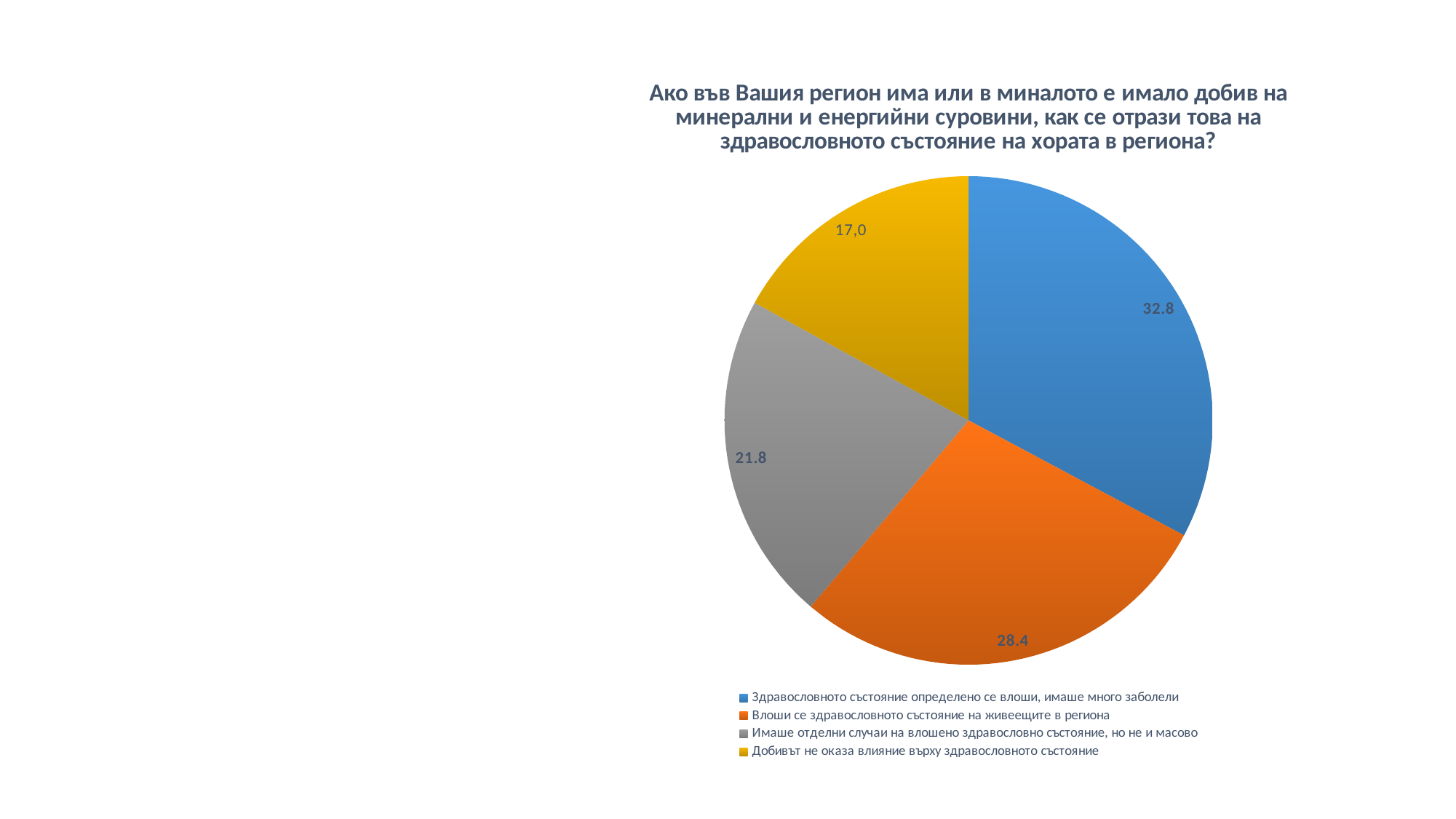
Which is larger: the value for "Имаше отделни случаи на влошено здравословно състояние, но не и масово" or the value for "Добивът не оказа влияние върху здравословното състояние"? Имаше отделни случаи на влошено здравословно състояние, но не и масово Which category has the smallest slice of the pie? Добивът не оказа влияние върху здравословното състояние What is the difference between the values for "Здравословното състояние определено се влоши, имаше много заболели" and "Влоши се здравословното състояние на живеещите в региона"? 4.4 How many entries does the legend list? 4 Which category has the largest slice of the pie? Здравословното състояние определено се влоши, имаше много заболели What is the value for "Влоши се здравословното състояние на живеещите в региона"? 28.4 What is the value for "Добивът не оказа влияние върху здравословното състояние"? 17,0 What colour is the slice for "Влоши се здравословното състояние на живеещите в региона"? orange What is the value for "Имаше отделни случаи на влошено здравословно състояние, но не и масово"? 21.8 How many slices does the pie chart have? 4 What is the value for "Здравословното състояние определено се влоши, имаше много заболели"? 32.8 What kind of chart is shown on the slide? pie chart